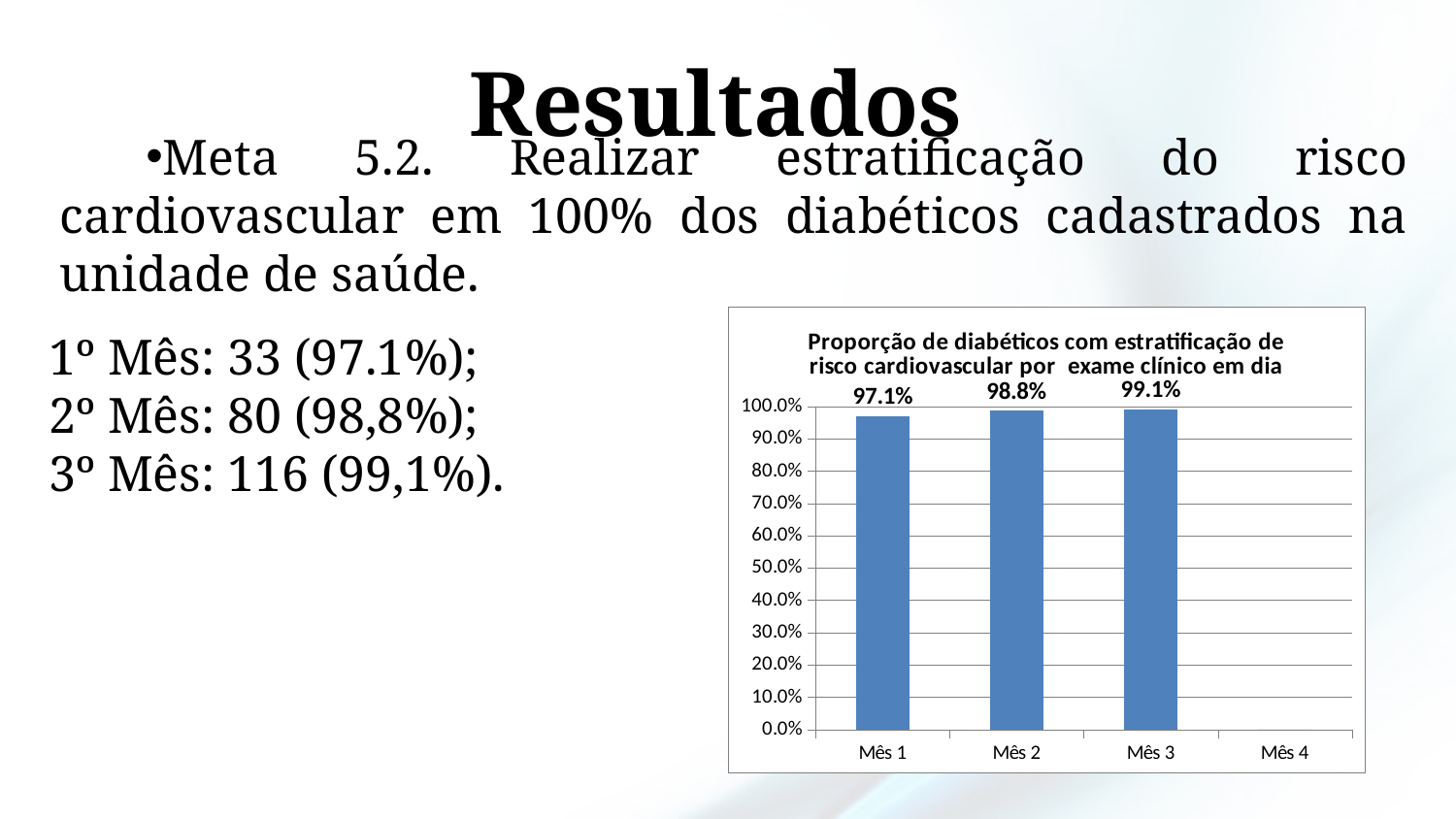
How many bars are plotted in the chart? 3 Do the values rise or fall from Mês 1 to Mês 3? Rise What is the value for Mês 1 in the chart? 97.1% What is the value for Mês 3 in the chart? 99.1% Which month with a plotted bar has the lowest value in the chart? Mês 1 Which month has the highest value in the chart? Mês 3 What is the value for Mês 2 in the chart? 98.8% What is the difference between the values for Mês 2 and Mês 1? 1.7% What is the difference between the values for Mês 3 and Mês 1? 2.0% What kind of chart is shown on the slide? Bar chart Which is larger, the value for Mês 2 or the value for Mês 1? Mês 2 Is the value for Mês 1 greater or less than 90.0%? greater